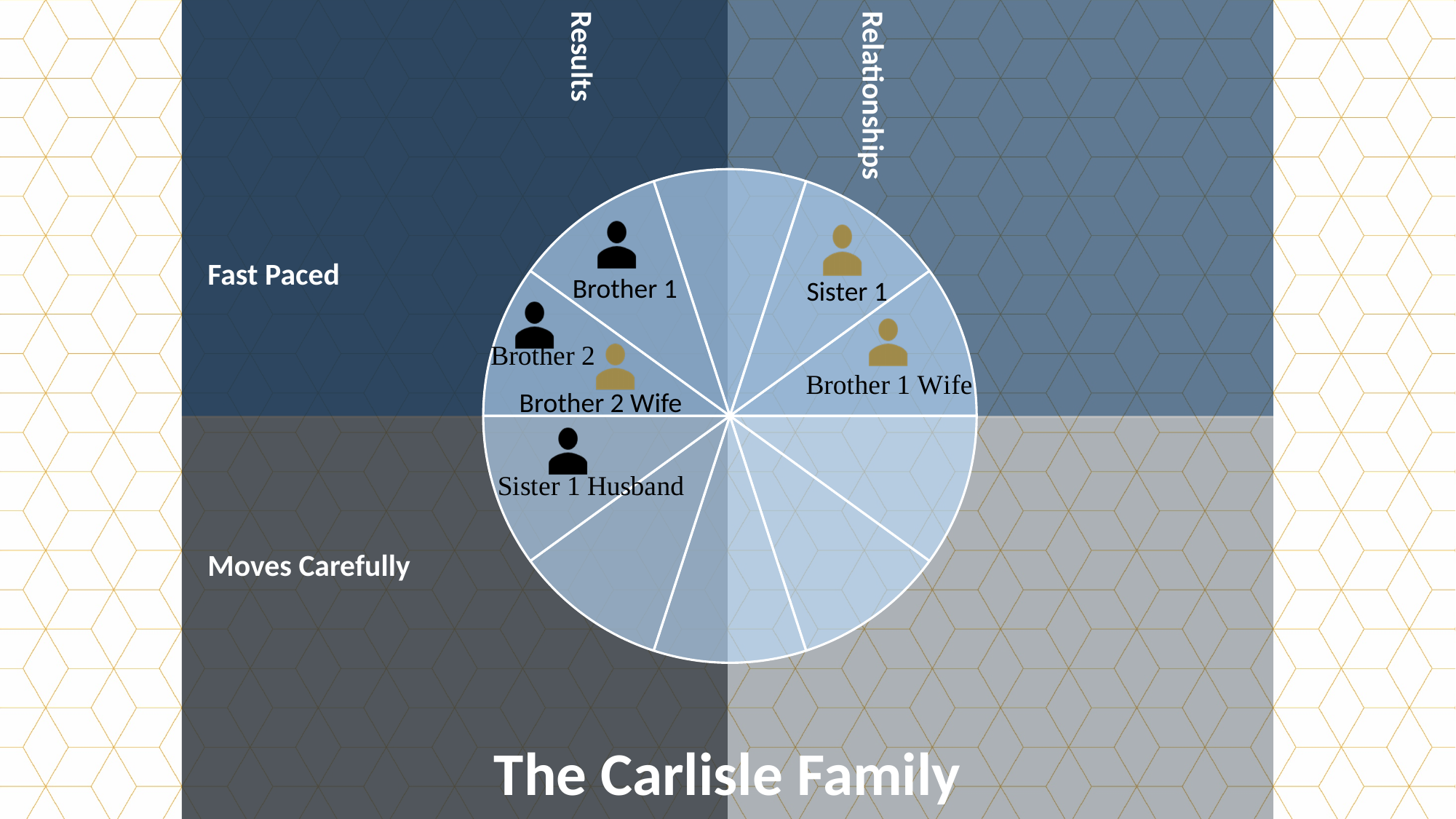
Which half of the pie chart, Results or Relationships, contains more family members? Results How many family members are placed in the Fast Paced / Results quadrant? 3 Which family member is placed in the Fast Paced / Relationships quadrant together with Sister 1? Brother 1 Wife Which family member is placed in the Moves Carefully / Results quadrant? Sister 1 Husband What kind of chart is shown on the slide? pie chart What is the title shown at the bottom of the slide? The Carlisle Family How many family members are placed in the Moves Carefully / Relationships quadrant? 0 How many family members are placed on the pie chart? 6 Which quadrant is Brother 2 placed in? Fast Paced / Results What are the two labels on the left side of the slide describing the vertical axis? Fast Paced and Moves Carefully